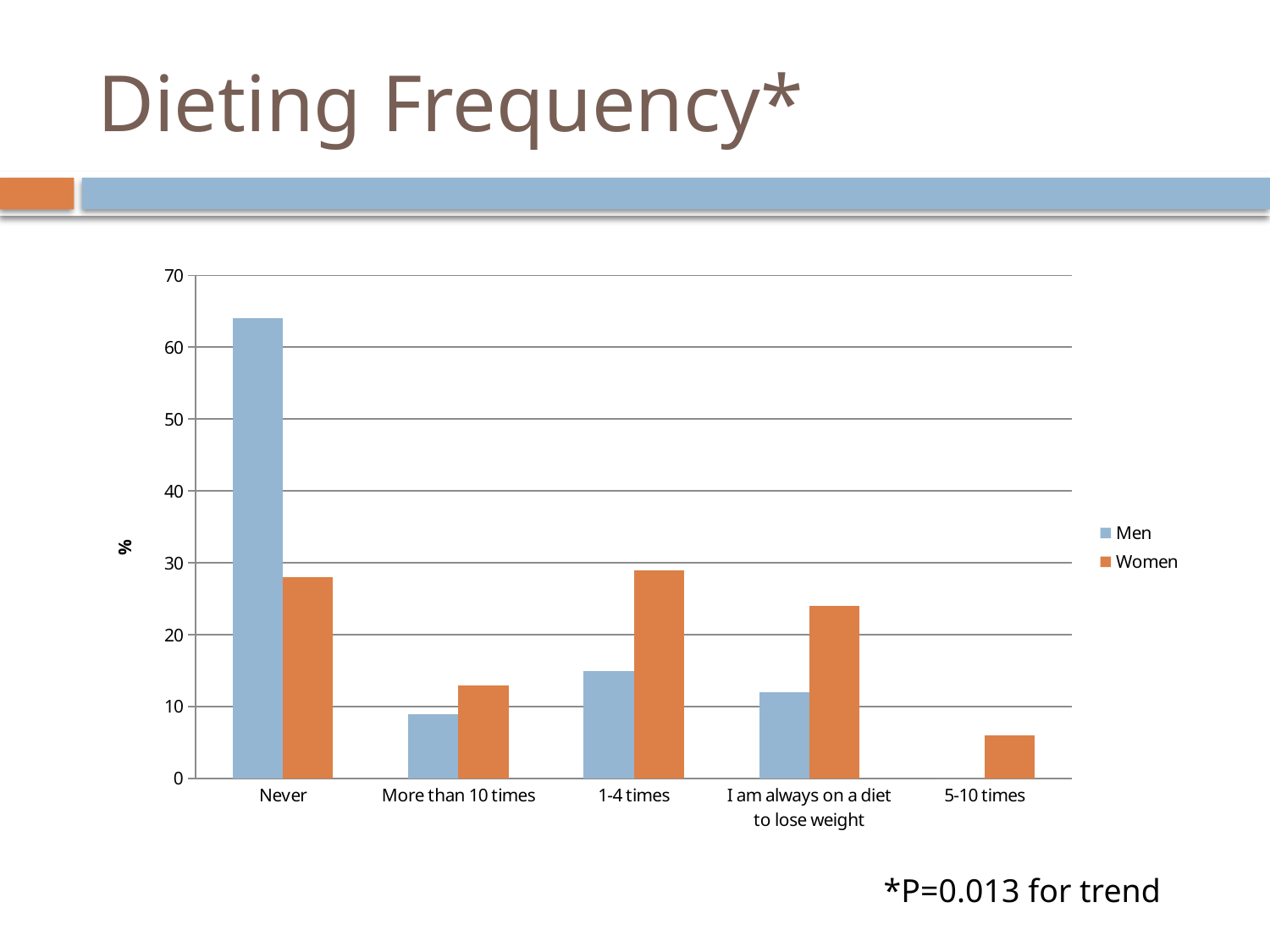
Is the value for Women in the 'I am always on a diet to lose weight' category greater or less than 20? greater Which category has the lowest value for Men? 5-10 times Which category has the highest value for Men? Never Is the value for Men in the Never category greater or less than 60? greater How many series does the legend list? 2 How many dieting frequency categories are shown on the x axis? 5 In the Never category, which is larger, the value for Men or for Women? Men Is the value for Women in the 5-10 times category greater or less than 10? less In the 1-4 times category, which is larger, the value for Men or for Women? Women What is the label on the vertical axis of the chart? % What kind of chart is shown on the slide? bar chart Which category has the lowest value for Women? 5-10 times